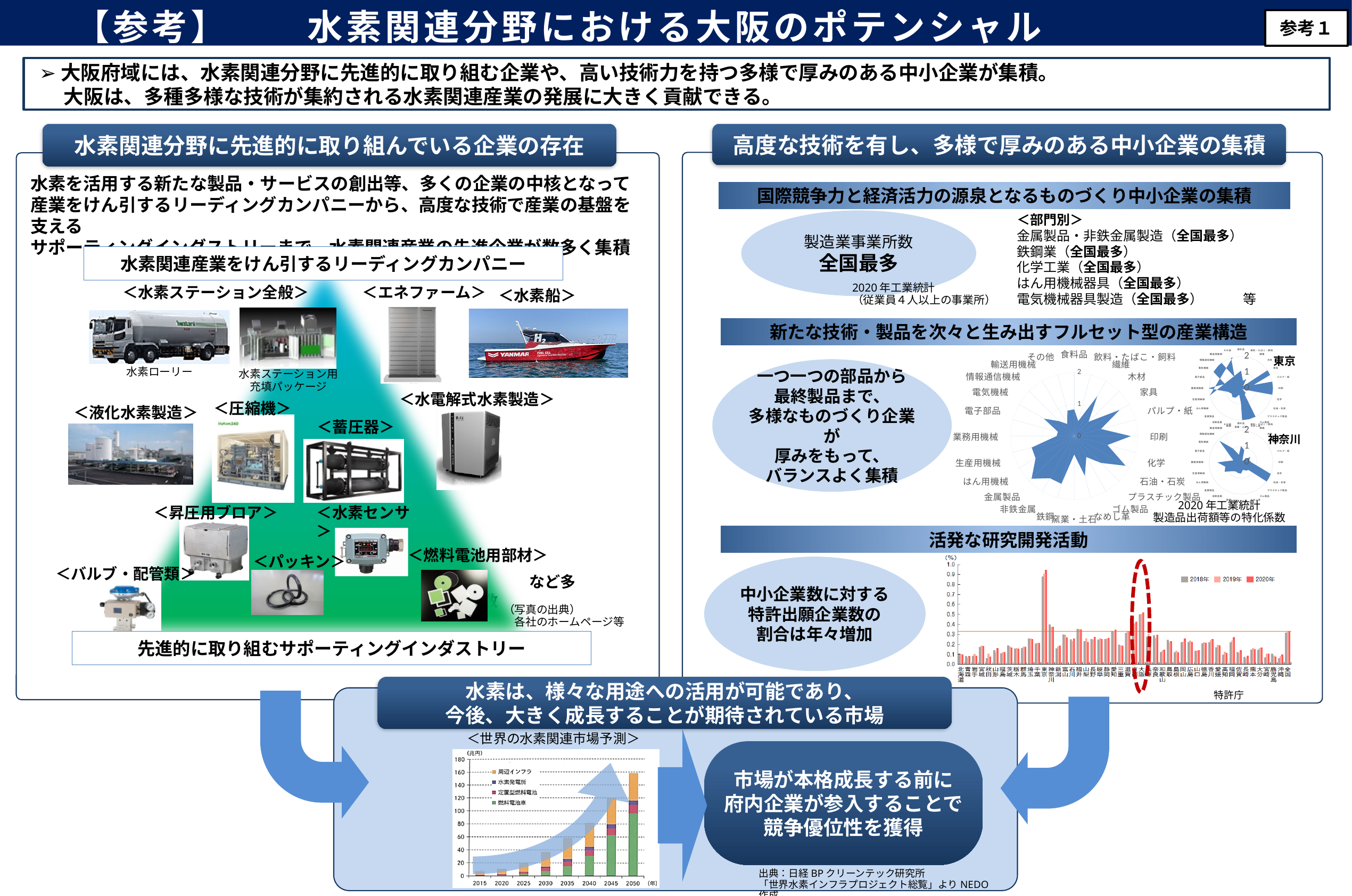
In the 世界の水素関連市場予測 chart, is the total for 2050 greater or less than 140? greater In the 世界の水素関連市場予測 chart, is the total for 2015 greater or less than 20? less What kind of chart is the 世界の水素関連市場予測 chart at the bottom of the slide? stacked bar chart In the 世界の水素関連市場予測 chart, do the stacked totals rise or fall from 2015 to 2050? rise In the 世界の水素関連市場予測 chart, which year has the highest stacked total? 2050 In the 世界の水素関連市場予測 chart, which series is listed first in the legend? 周辺インフラ In the 世界の水素関連市場予測 chart, is the total for 2045 greater or less than 100? greater How many series does the legend of the 世界の水素関連市場予測 chart list? 4 What kind of chart is the 製造品出荷額等の特化係数 chart on the right side of the slide? radar chart How many series does the legend of the 活発な研究開発活動 patent chart on the right list? 3 How many years are shown on the x axis of the 世界の水素関連市場予測 chart? 8 What unit is shown on the y axis of the 世界の水素関連市場予測 chart? 兆円